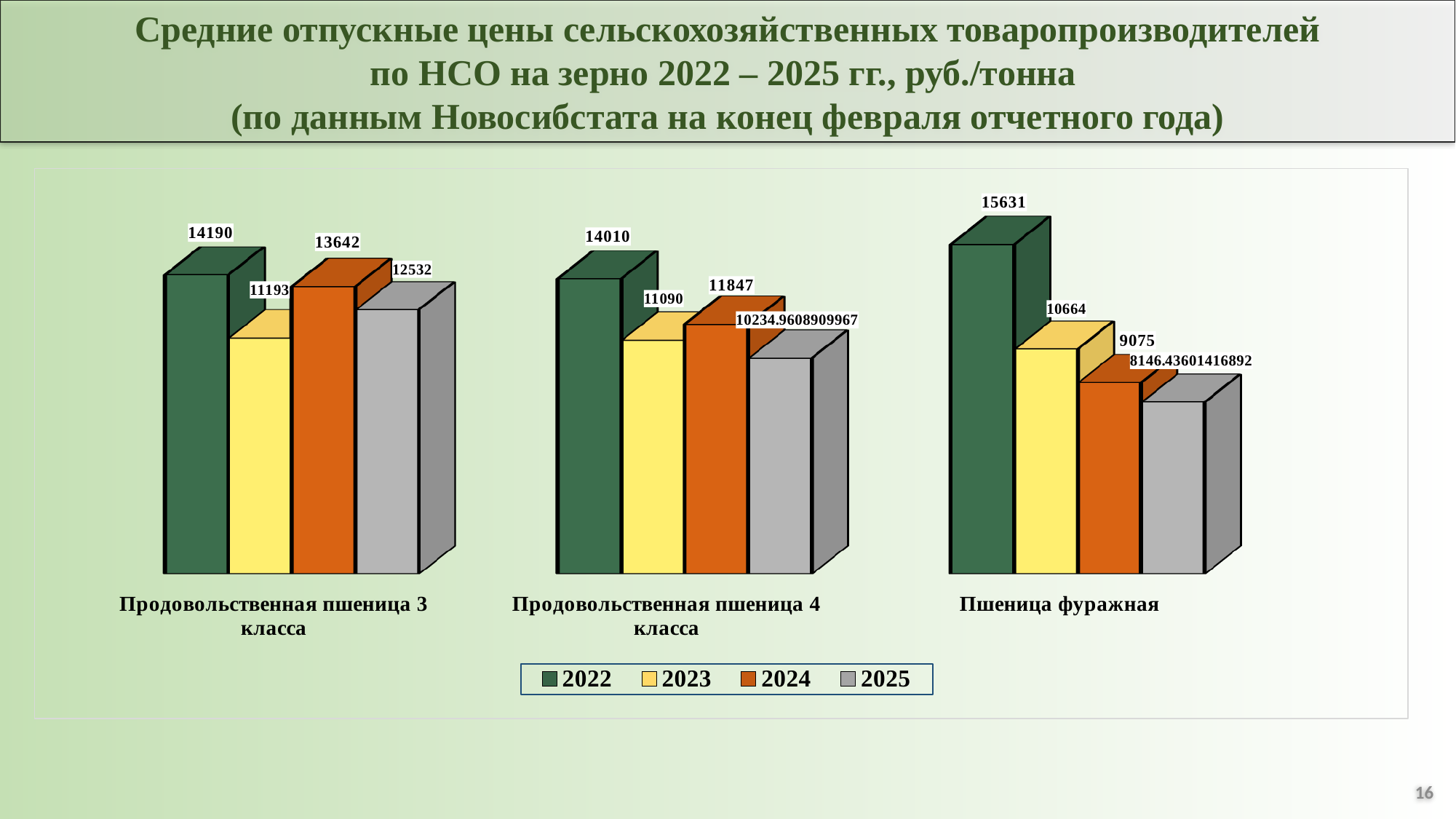
What type of chart is shown on the slide? Bar chart Which series is shown in orange in the legend? 2024 What is the difference between the 2022 and 2023 values for Продовольственная пшеница 3 класса? 2997 What is the 2023 value for Продовольственная пшеница 4 класса? 11090 What is the 2024 value for Пшеница фуражная? 9075 How many categories are shown on the x axis? 3 Which category has the highest 2022 value? Пшеница фуражная How many series does the legend list? 4 What is the 2022 value for Продовольственная пшеница 3 класса? 14190 What is the 2025 value for Продовольственная пшеница 3 класса? 12532 Which is larger for Продовольственная пшеница 4 класса: the 2023 value or the 2024 value? 2024 Which category has the lowest 2024 value? Пшеница фуражная